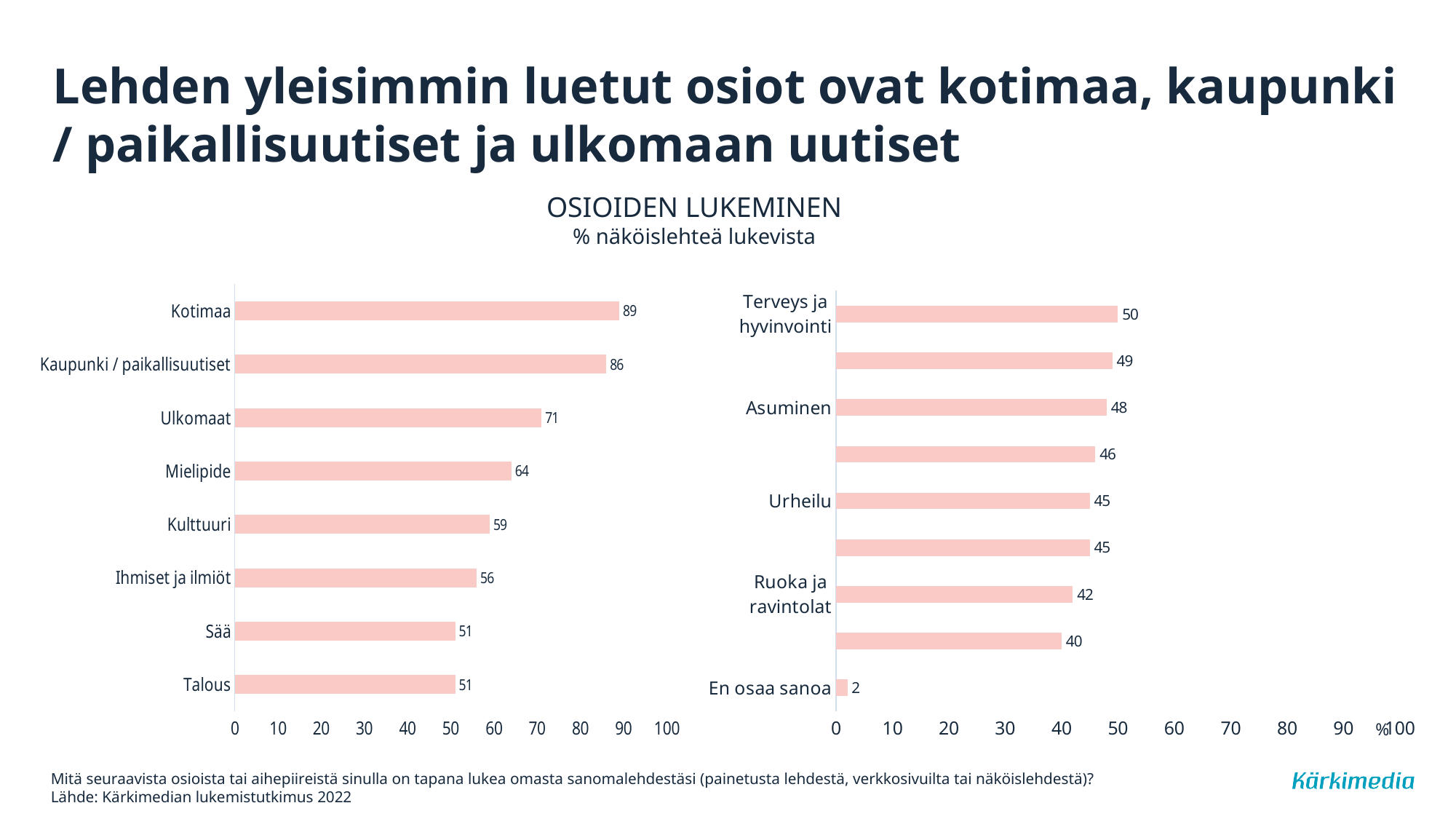
In the left chart, which is larger, the value for Mielipide or the value for Kulttuuri? Mielipide In the right chart, which category has the lowest value? En osaa sanoa In the left chart, what is the value for Kotimaa? 89 In the right chart, is the value for Urheilu greater or less than 50? less What kind of chart is the left chart? bar chart In the left chart, what is the difference between the values for Kotimaa and Kaupunki / paikallisuutiset? 3 In the right chart, what is the value for Ruoka ja ravintolat? 42 In the right chart, what is the value for Asuminen? 48 In the left chart, which category has the highest value? Kotimaa What is the title shown above the two charts? OSIOIDEN LUKEMINEN In the left chart, what is the value for Ulkomaat? 71 How many categories are shown in the left chart? 8